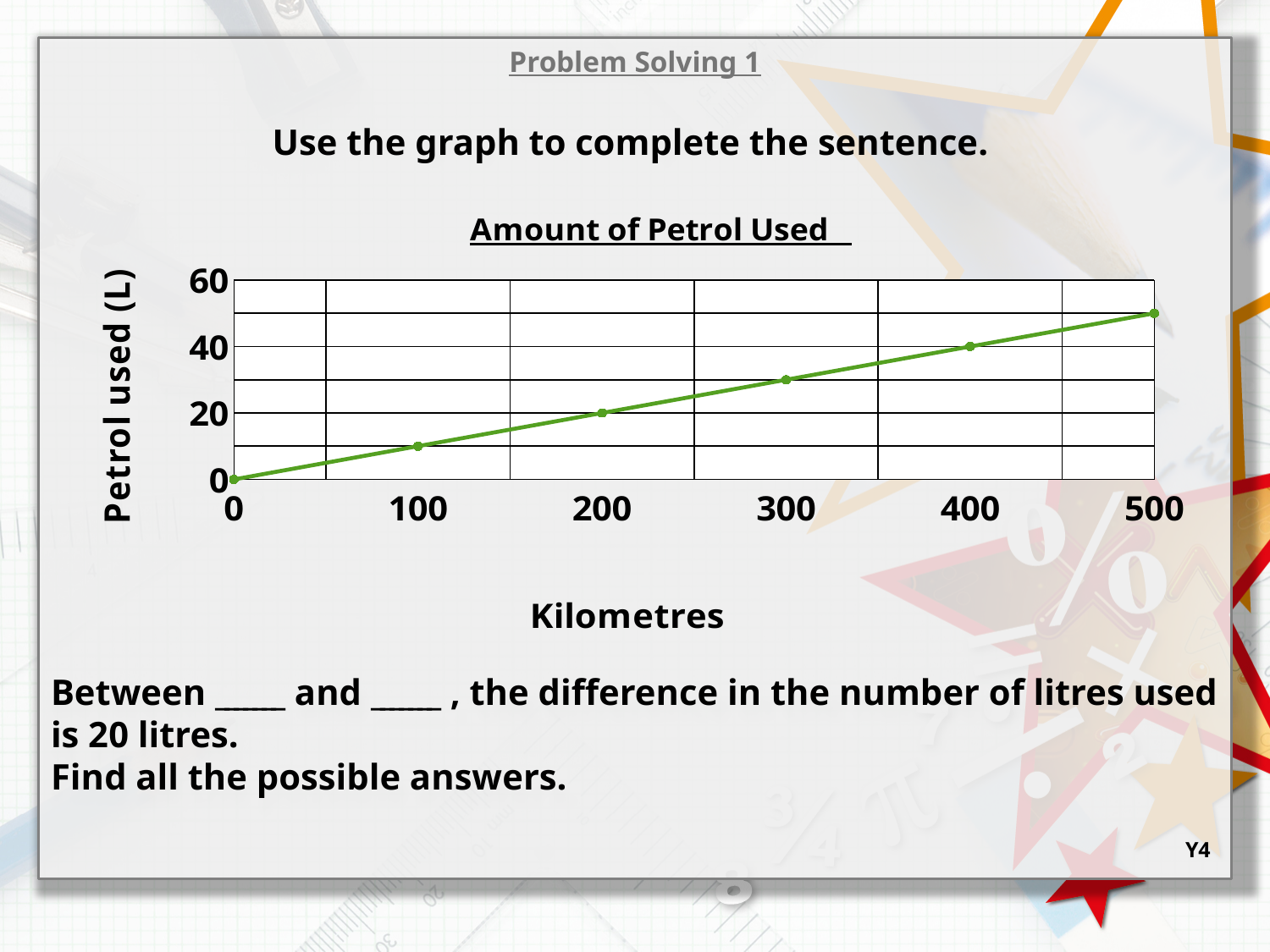
What is the difference in litres of petrol used between 400 kilometres and 200 kilometres? 20 What is the title of the chart? Amount of Petrol Used What is the label of the vertical axis? Petrol used (L) How many data points are plotted on the line? 6 Is the petrol used at 100 kilometres greater or less than 20 litres? less How many litres of petrol are used at 0 kilometres? 0 Is the petrol used at 500 kilometres greater or less than 40 litres? greater What type of chart is shown on the slide? line chart How many litres of petrol are used at 200 kilometres? 20 At which number of kilometres is the petrol used highest? 500 How many litres of petrol are used at 400 kilometres? 40 Does the petrol used rise or fall as the kilometres increase? rise